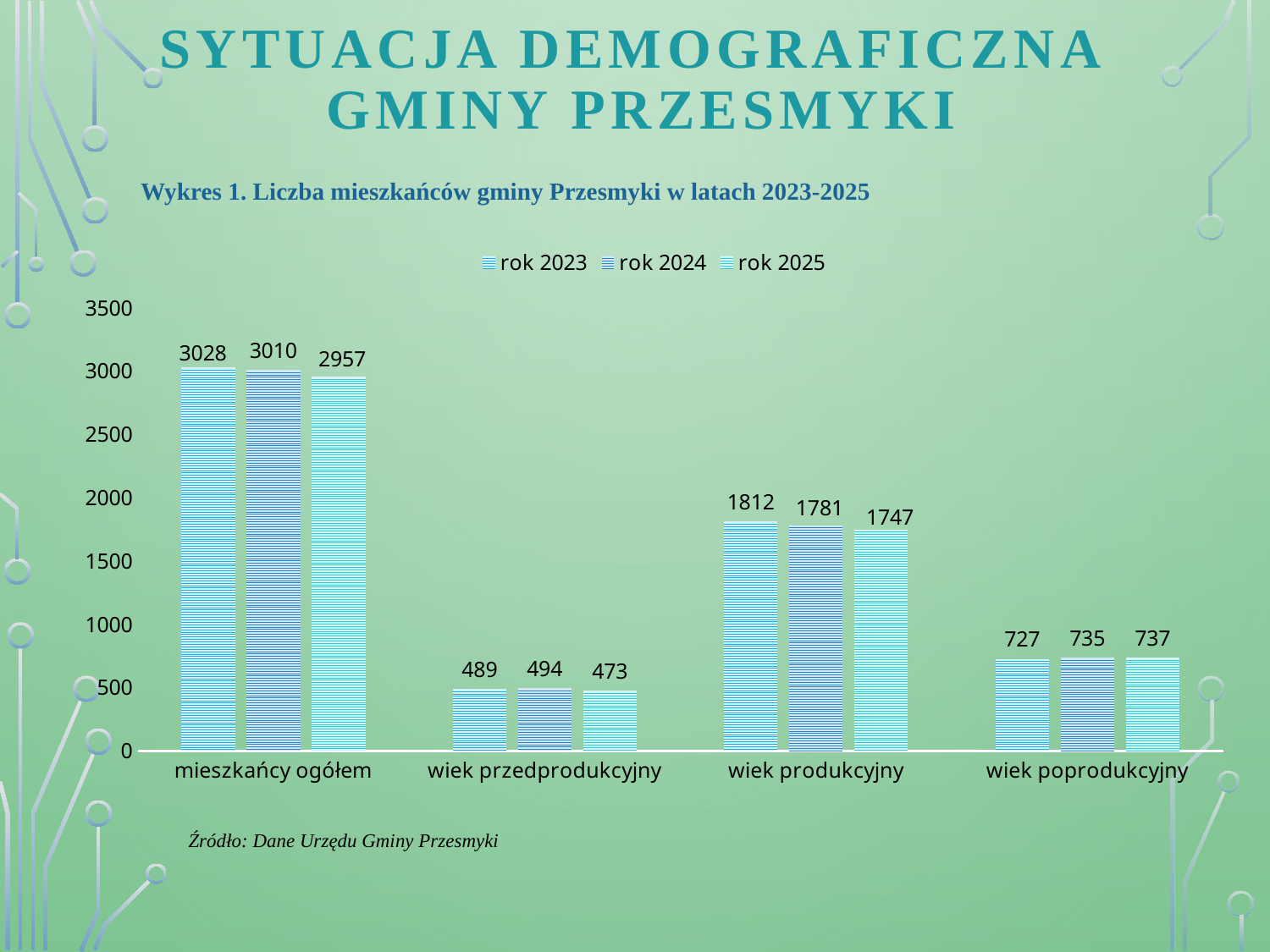
What is the difference between the 'rok 2023' and 'rok 2025' values for 'mieszkańcy ogółem'? 71 What is the title of the chart? Wykres 1. Liczba mieszkańców gminy Przesmyki w latach 2023-2025 Which category has the highest value in the 'rok 2024' series? mieszkańcy ogółem What is the value for 'mieszkańcy ogółem' in the 'rok 2023' series? 3028 How many categories are shown on the x axis? 4 What kind of chart is shown on the slide? bar chart Which is larger: the 'rok 2023' value for 'wiek produkcyjny' or the 'rok 2025' value for 'wiek produkcyjny'? rok 2023 Which category has the lowest value in the 'rok 2025' series? wiek przedprodukcyjny How many series does the legend list? 3 What is the value for 'wiek poprodukcyjny' in the 'rok 2024' series? 735 What is the value for 'wiek produkcyjny' in the 'rok 2025' series? 1747 Is the 'rok 2024' value for 'wiek przedprodukcyjny' greater or less than 500? less